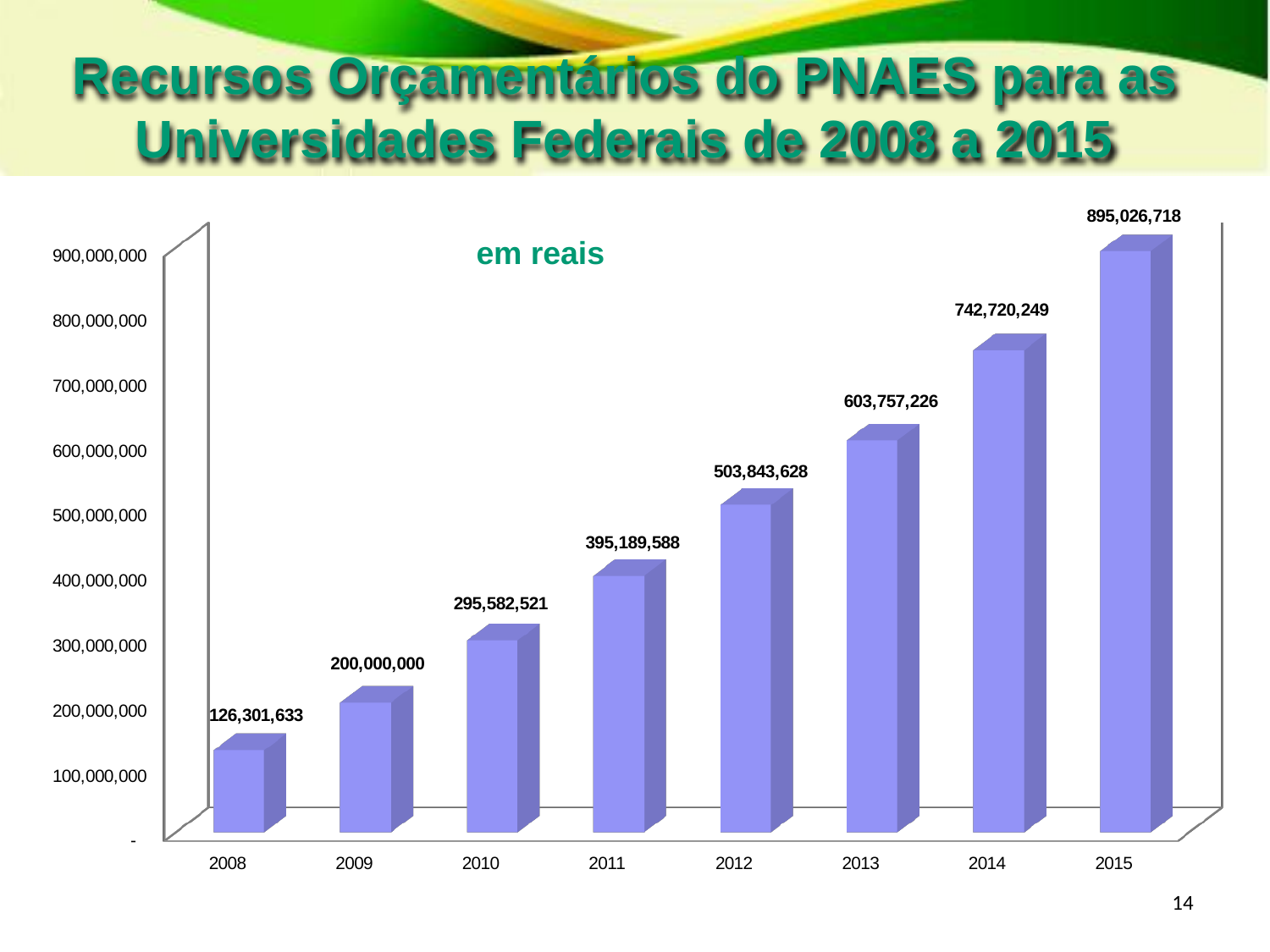
What is the difference between the values for 2009 and 2008? 73,698,367 Is the value for 2010 greater or less than 200,000,000? greater What kind of chart is shown on the slide? bar chart How many years are shown on the x axis? 8 What is the difference between the values for 2015 and 2014? 152,306,469 Which year has the highest value? 2015 What is the value for 2008? 126,301,633 What is the value for 2015? 895,026,718 Which year has the lowest value? 2008 Which is larger, the value for 2011 or the value for 2012? 2012 What is the value for 2012? 503,843,628 Do the values rise or fall from 2008 to 2015? rise